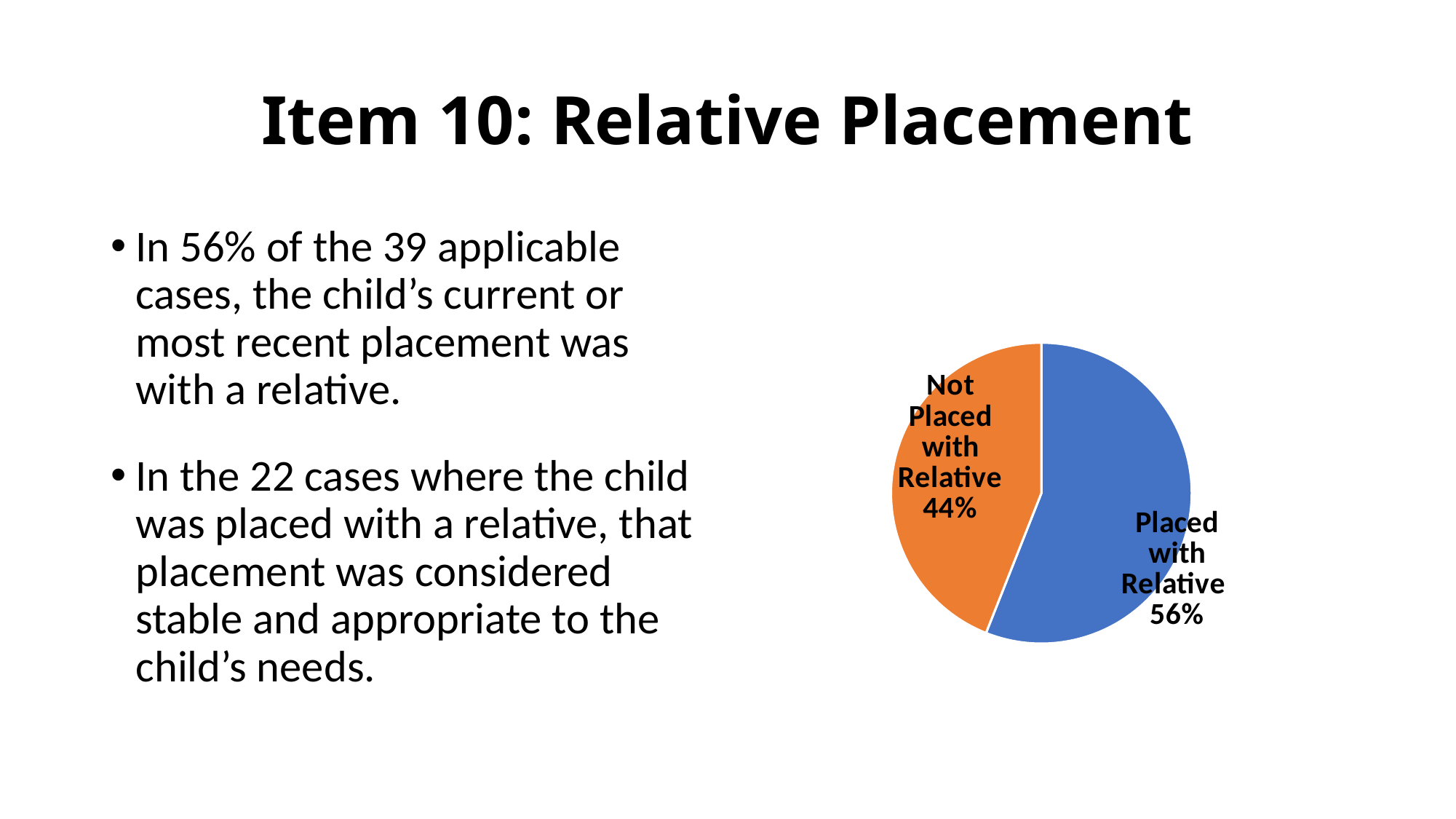
Which slice of the pie is the largest? Placed with Relative Is the share for "Placed with Relative" greater or less than 50%? greater What kind of chart is shown on the slide? Pie chart Is the share for "Not Placed with Relative" greater or less than 50%? less What share of the pie is labelled "Placed with Relative"? 56% What share of the pie is labelled "Not Placed with Relative"? 44% What colour is the "Not Placed with Relative" slice? Orange Which is larger: the "Placed with Relative" slice or the "Not Placed with Relative" slice? Placed with Relative What is the difference in percentage points between the "Placed with Relative" and "Not Placed with Relative" slices? 12 How many slices does the pie chart have? 2 What colour is the "Placed with Relative" slice? Blue Which slice of the pie is the smallest? Not Placed with Relative